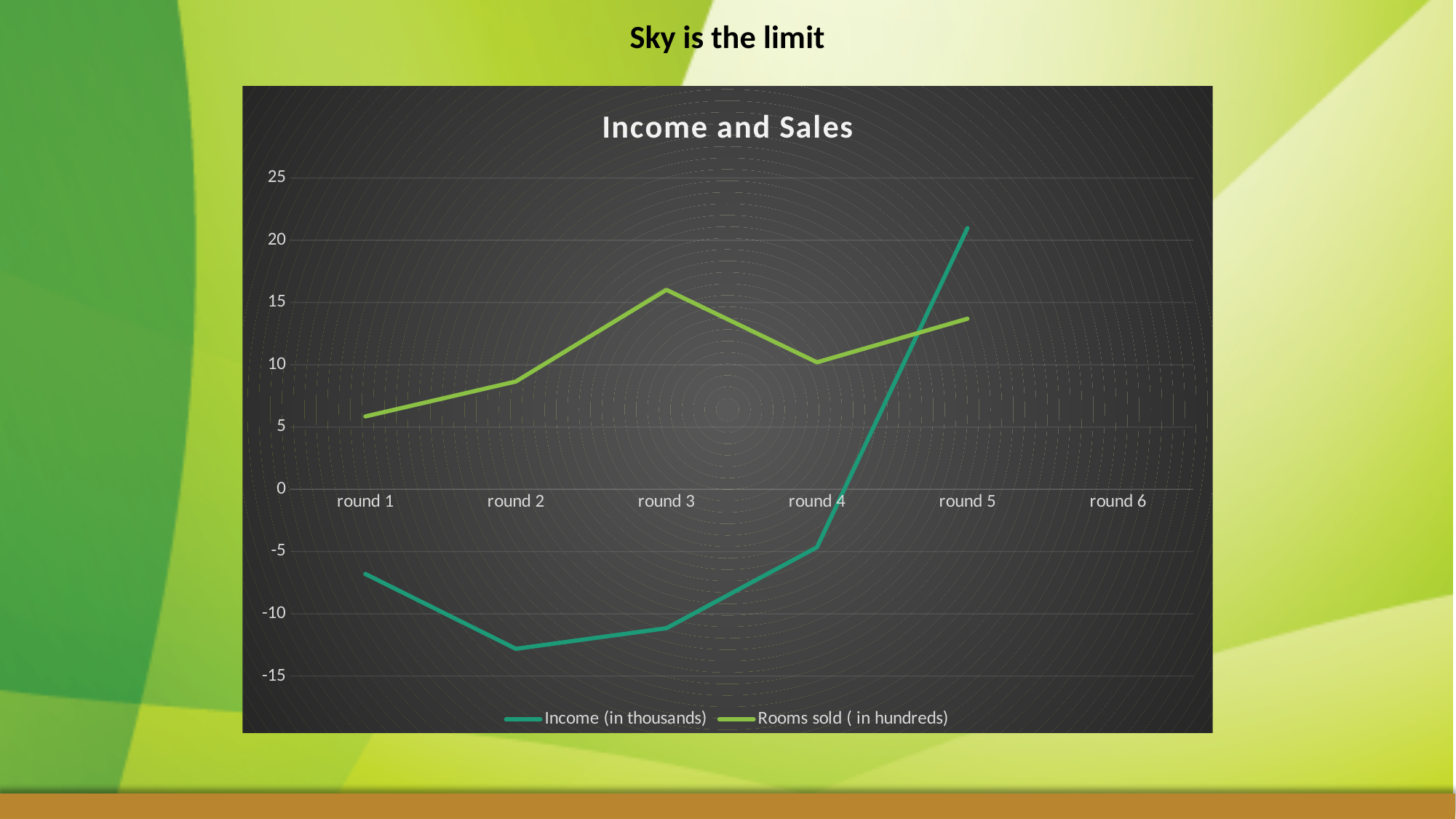
Is the value for Rooms sold ( in hundreds) in round 3 greater or less than 15? greater In which round is Rooms sold ( in hundreds) highest? round 3 Is the value for Income (in thousands) in round 1 greater or less than -5? less What kind of chart is shown on the slide? line chart What is the title of the chart? Income and Sales In which round is Income (in thousands) highest? round 5 Is the value for Income (in thousands) in round 5 greater or less than 20? greater In which round is Income (in thousands) lowest? round 2 What are the two series named in the legend? Income (in thousands) and Rooms sold ( in hundreds) In round 4, which series has the larger value, Income (in thousands) or Rooms sold ( in hundreds)? Rooms sold ( in hundreds) How many round labels are shown on the x axis? 6 How many series does the legend list? 2